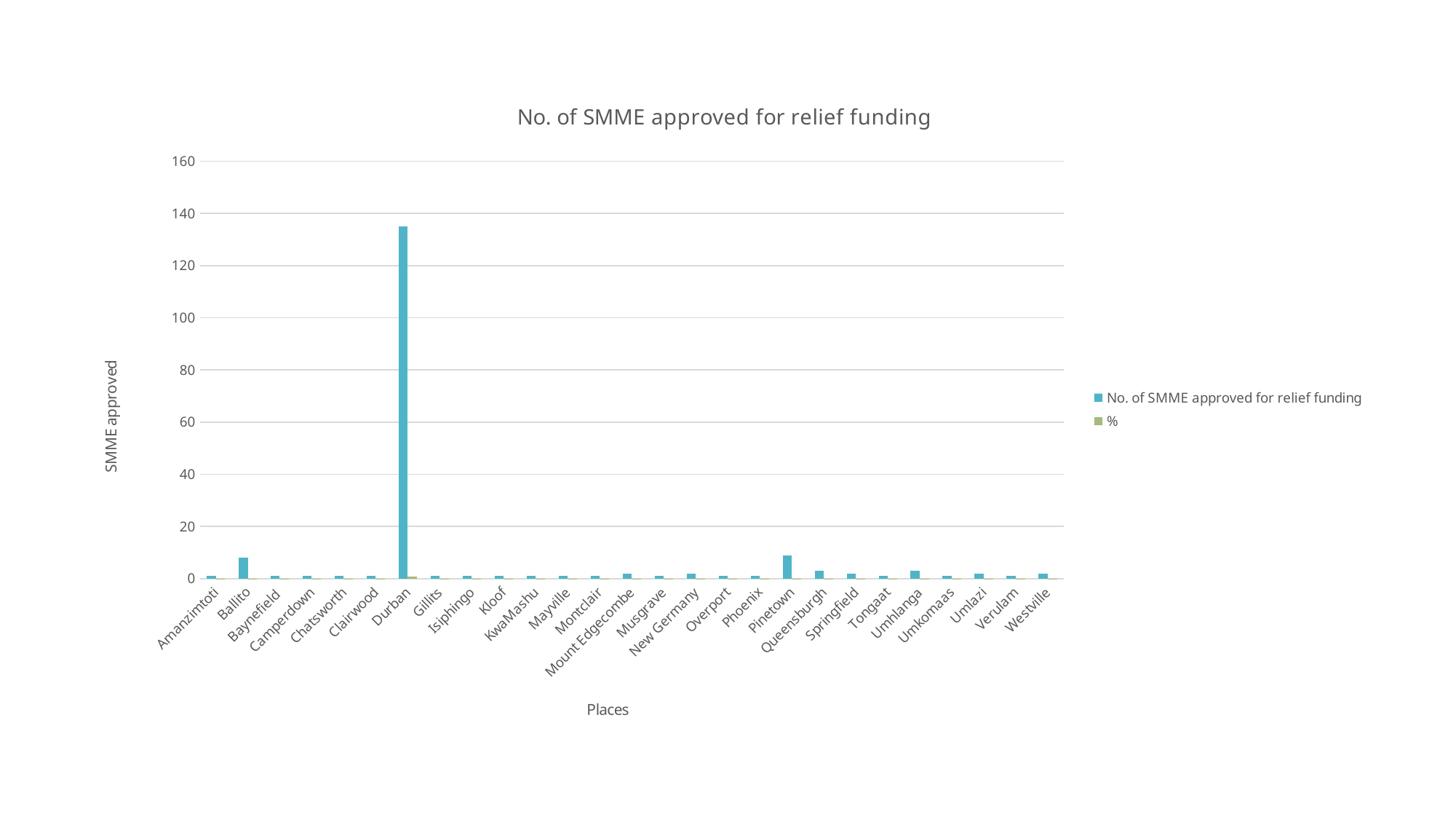
Which place has the highest number of SMME approved for relief funding? Durban What is the label on the x axis of the chart? Places What is the title of the chart? No. of SMME approved for relief funding How many places are shown on the x axis? 27 Which has a larger number of SMME approved for relief funding, Ballito or Amanzimtoti? Ballito Is the value for Pinetown greater or less than 20? less How many series does the legend list? 2 Is the value for Ballito greater or less than 20? less Is the value for Durban greater or less than 140? less What kind of chart is shown on the slide? bar chart Which has a larger number of SMME approved for relief funding, Durban or Pinetown? Durban